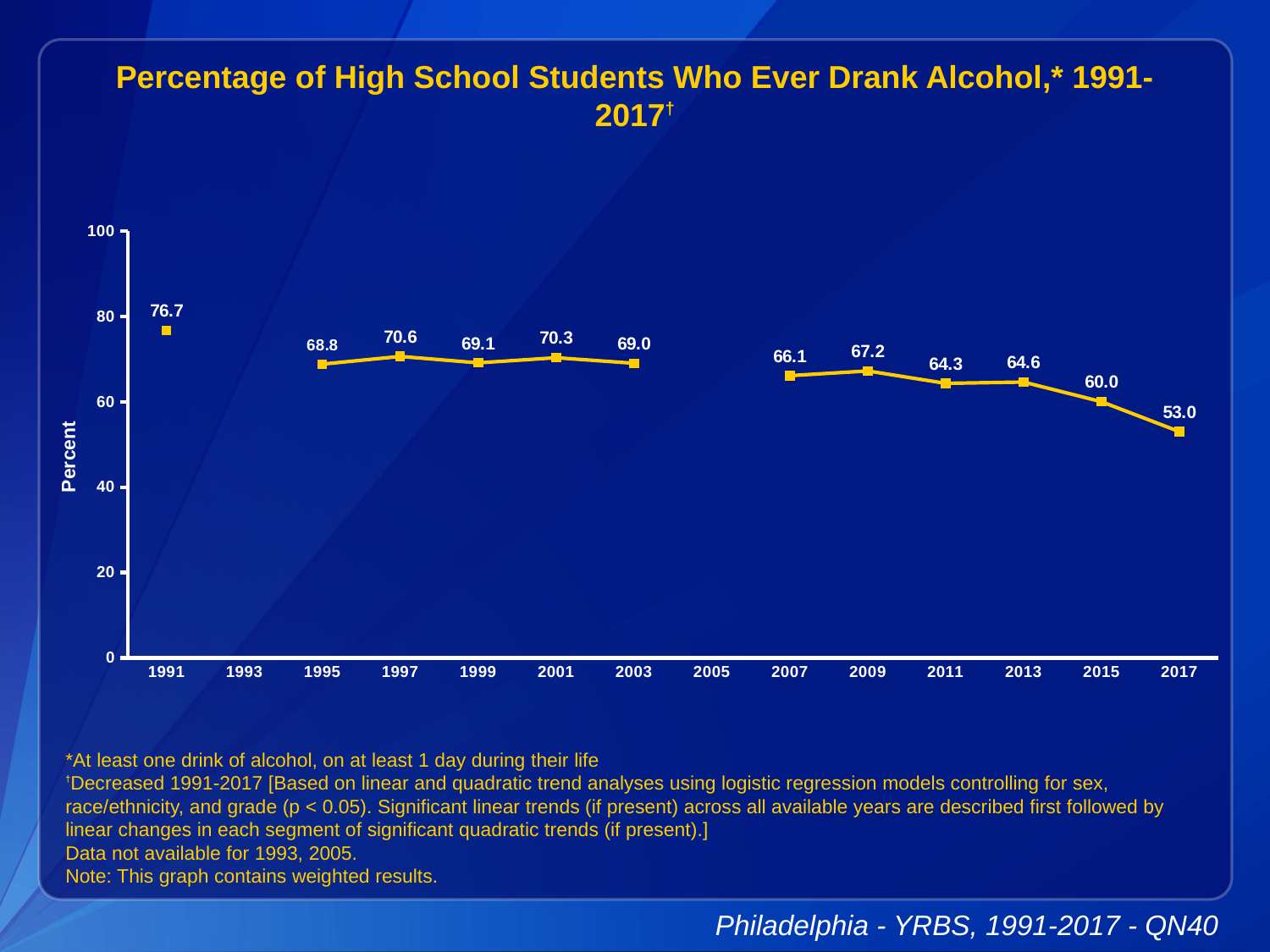
Which year has the lowest percentage? 2017 What is the difference between the 1991 value and the 2017 value? 23.7 What is the label on the vertical axis? Percent How many years have data points plotted on the chart? 12 What is the value plotted for 2009? 67.2 What kind of chart is shown on the slide? Line chart What is the value plotted for 2017? 53.0 Is the value for 2013 greater or less than 60? greater What is the difference between the 2015 value and the 2017 value? 7.0 What percentage of high school students had ever drunk alcohol in 1991? 76.7 Which year has a higher value, 1997 or 2011? 1997 Which year has the highest percentage? 1991